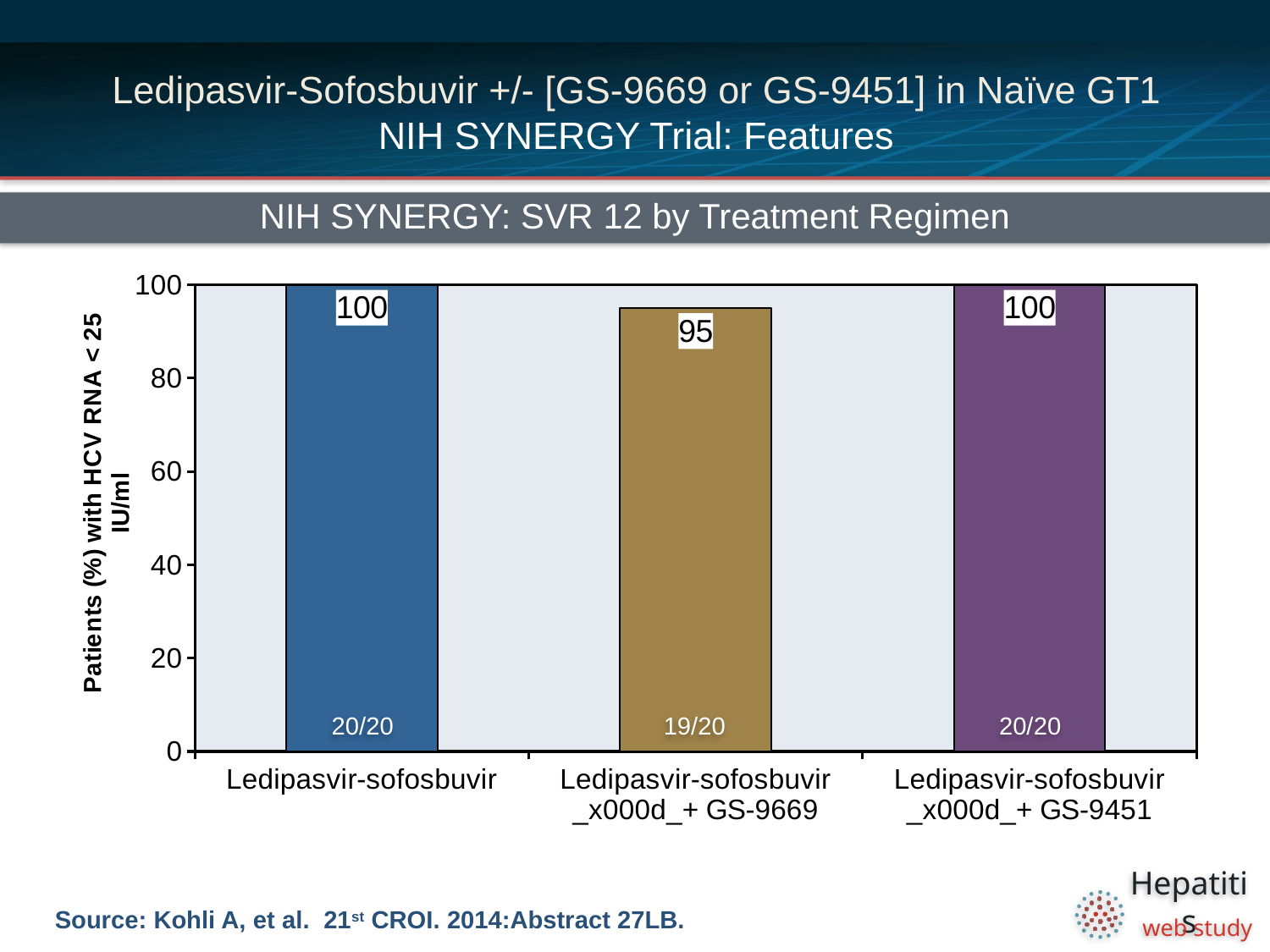
Which is larger, the SVR 12 value for Ledipasvir-sofosbuvir + GS-9451 or for Ledipasvir-sofosbuvir + GS-9669? Ledipasvir-sofosbuvir + GS-9451 What is the SVR 12 value for Ledipasvir-sofosbuvir alone? 100 What kind of chart is shown on the slide? Bar chart What is the label of the y-axis? Patients (%) with HCV RNA < 25 IU/ml Which treatment regimen has the lowest SVR 12 value? Ledipasvir-sofosbuvir + GS-9669 What is the title of the chart? NIH SYNERGY: SVR 12 by Treatment Regimen What is the SVR 12 value for Ledipasvir-sofosbuvir + GS-9451? 100 How many treatment regimens are shown on the chart? 3 What patient fraction is shown inside the bar for Ledipasvir-sofosbuvir + GS-9669? 19/20 What is the SVR 12 value for Ledipasvir-sofosbuvir + GS-9669? 95 What is the difference between the SVR 12 values for Ledipasvir-sofosbuvir alone and Ledipasvir-sofosbuvir + GS-9669? 5 Is the value for Ledipasvir-sofosbuvir + GS-9669 greater or less than 80? greater